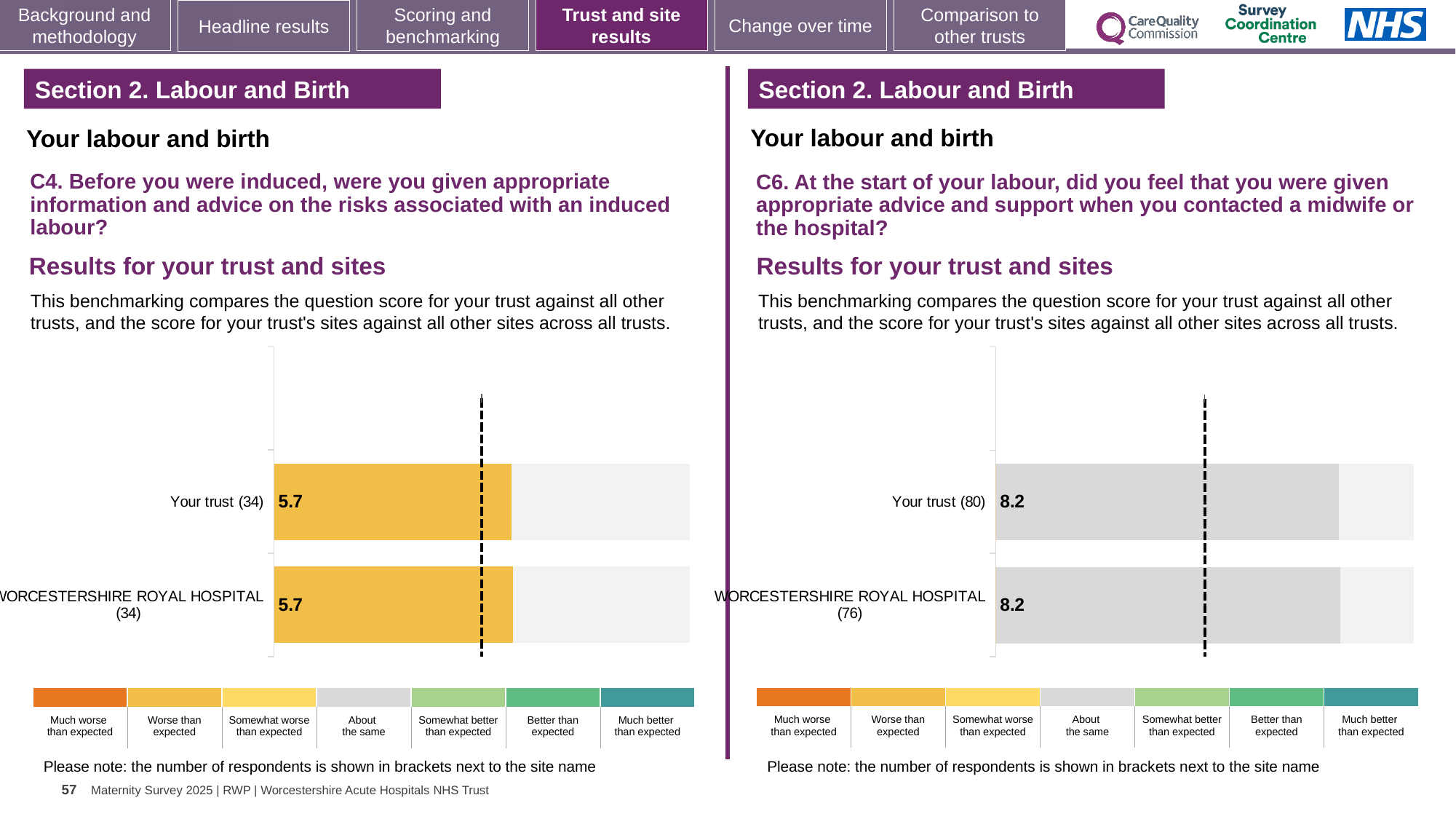
In the left chart (C4), how many respondents are shown in brackets for Your trust? 34 In the left chart (C4), what is the difference between the score for Your trust and the score for Worcestershire Royal Hospital? 0 How many bars are plotted in the right chart (C6)? 2 In the right chart (C6), what is the score for Worcestershire Royal Hospital? 8.2 In the left chart (C4), what is the score for Your trust? 5.7 How many bars are plotted in the left chart (C4)? 2 How many categories does the colour key below the right chart (C6) list? 7 In the right chart (C6), what is the score for Your trust? 8.2 In the right chart (C6), how many respondents are shown in brackets for Worcestershire Royal Hospital? 76 In the left chart (C4), what is the score for Worcestershire Royal Hospital? 5.7 What kind of chart is used in the left chart (C4)? Bar chart In the right chart (C6), what is the difference between the score for Your trust and the score for Worcestershire Royal Hospital? 0